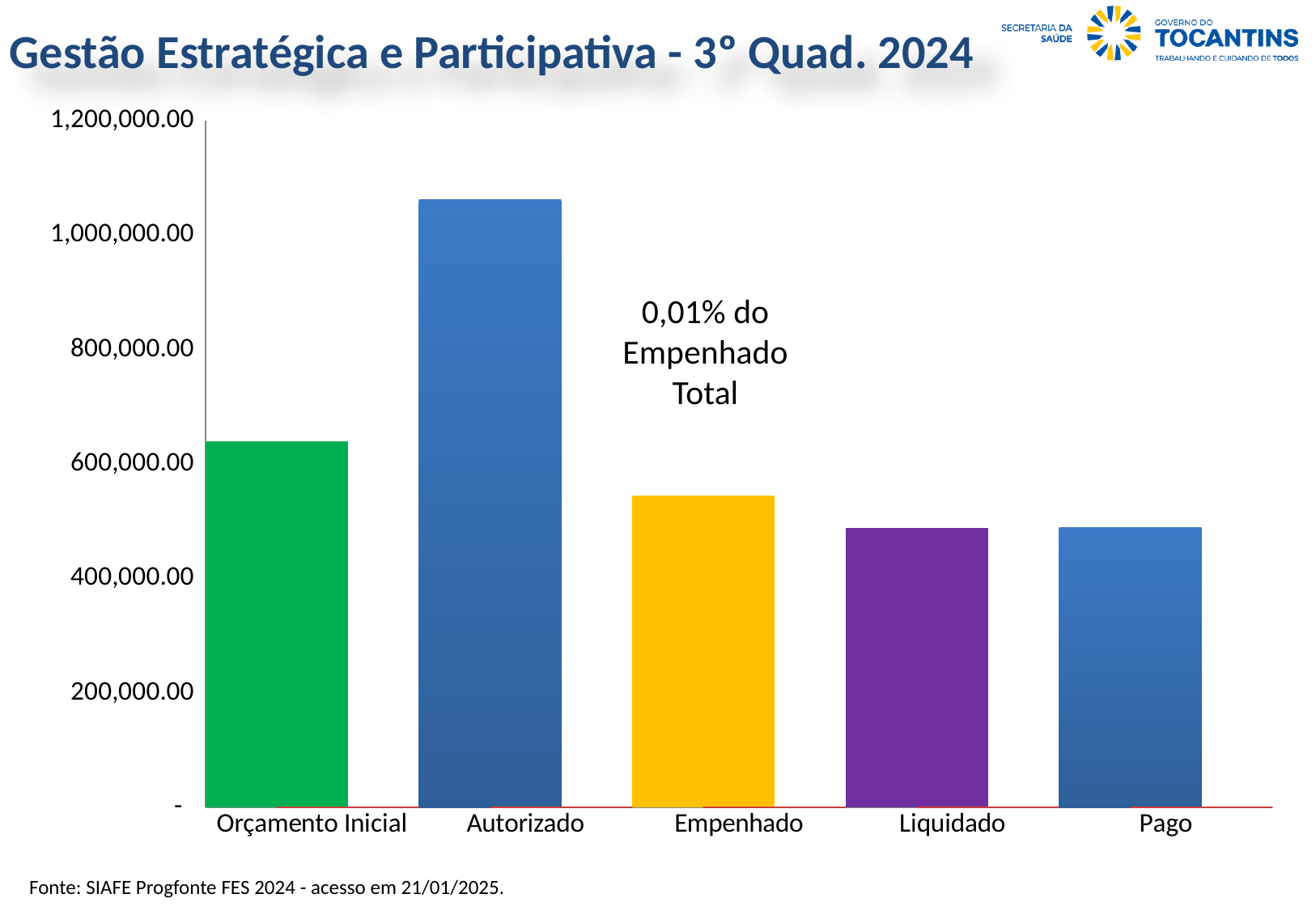
Is the value for Pago greater or less than 600,000.00? less Which is larger, the value for Autorizado or the value for Orçamento Inicial? Autorizado What text annotation is printed inside the chart area? 0,01% do Empenhado Total What kind of chart is shown on the slide? bar chart Is the value for Orçamento Inicial greater or less than 600,000.00? greater Is the value for Empenhado greater or less than 600,000.00? less Which category has the highest value? Autorizado Which is larger, the value for Empenhado or the value for Liquidado? Empenhado What is the title of the slide? Gestão Estratégica e Participativa - 3° Quad. 2024 How many categories are plotted on the x axis? 5